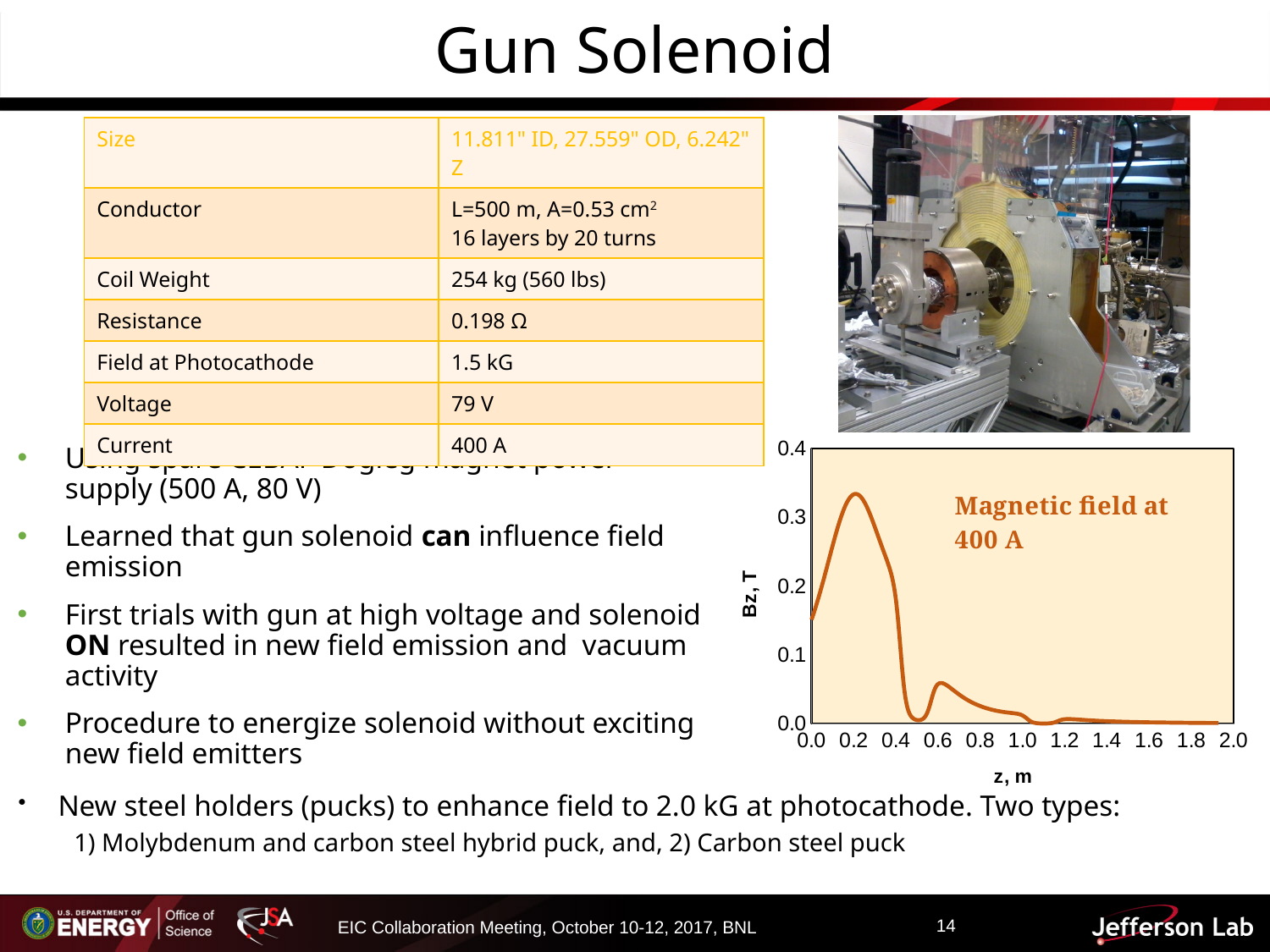
Is the value of Bz at z = 0.0 m greater or less than 0.2? less What kind of chart is shown on the slide? line chart What is the title of the chart? Magnetic field at 400 A Which is larger, the value of Bz at z = 0.2 m or at z = 0.8 m? z = 0.2 m Is the value of Bz at z = 1.0 m greater or less than 0.1? less What is the highest value shown on the horizontal axis of the chart? 2.0 Is the peak value of Bz on the chart greater or less than 0.3? greater Does Bz rise or fall along the z axis between z = 0.0 m and z = 0.2 m? rise Does Bz rise or fall along the z axis between z = 0.2 m and z = 0.4 m? fall What is the label of the vertical axis of the chart? Bz, T